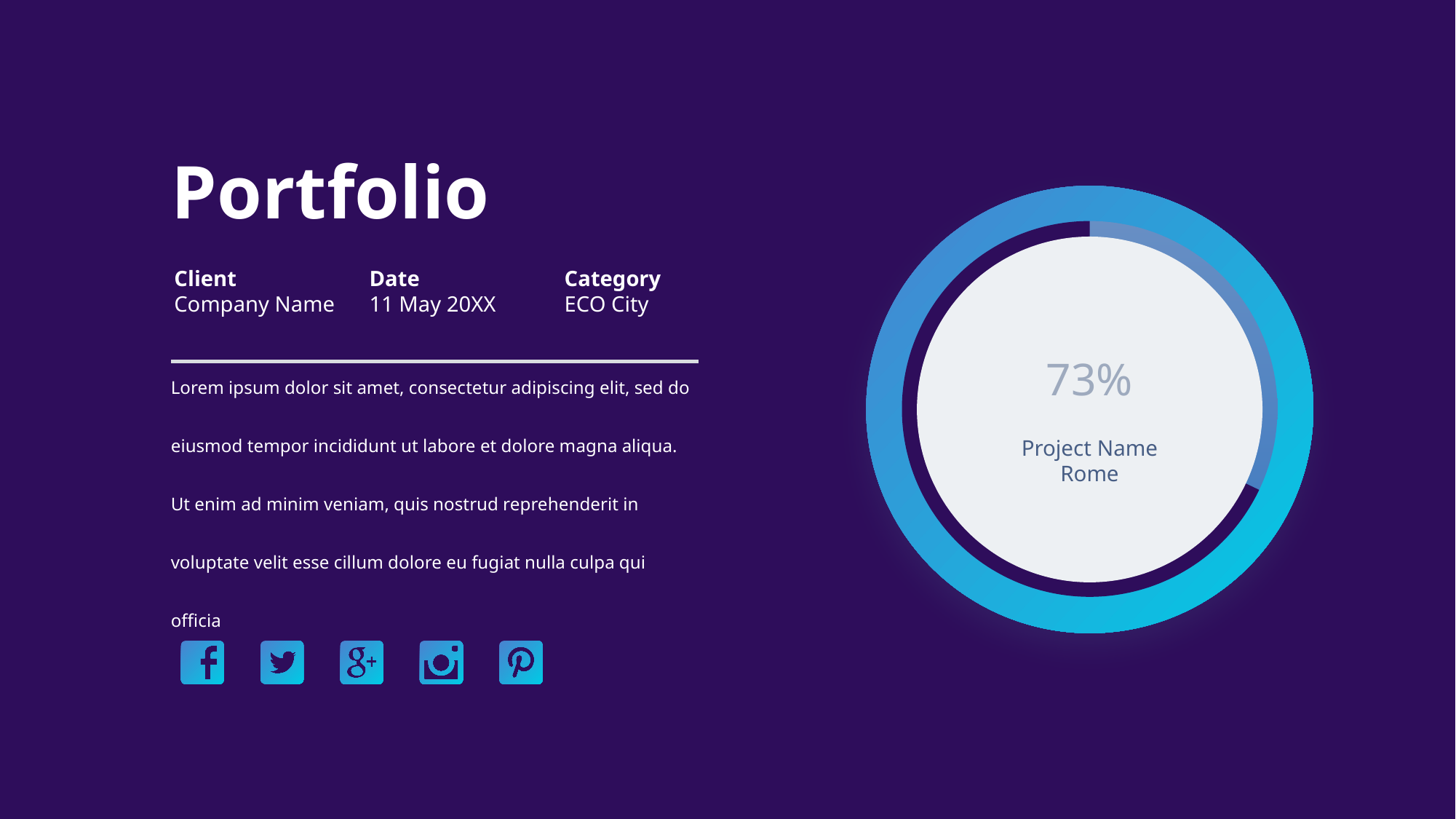
Which project name is labelled inside the donut chart? Rome What colour is the filled ring of the donut chart? blue Is the value shown in the donut chart greater or less than 75%? less What kind of chart is shown on the right of the slide? donut chart How many percentage values are displayed on the donut chart? 1 Is the value shown in the donut chart greater or less than 50%? greater What percentage value is displayed in the centre of the donut chart? 73%